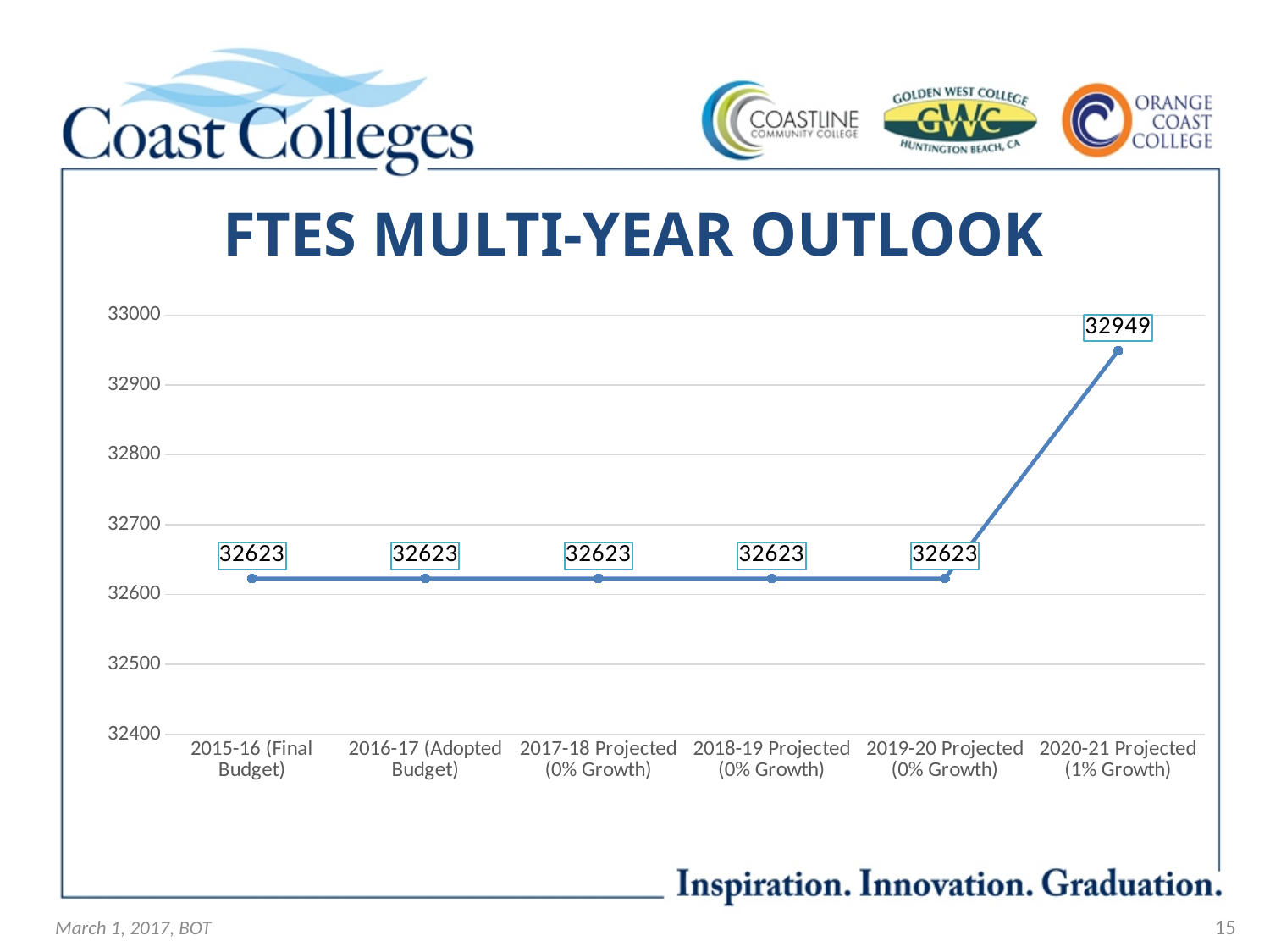
Which is larger, the FTES value for 2020-21 Projected (1% Growth) or 2016-17 (Adopted Budget)? 2020-21 Projected (1% Growth) What kind of chart is shown on the slide? line chart Which year has the highest FTES value? 2020-21 Projected (1% Growth) Do the FTES values rise, fall, or stay flat from 2015-16 (Final Budget) to 2019-20 Projected (0% Growth)? stay flat What is the FTES value for 2015-16 (Final Budget)? 32623 Is the FTES value for 2020-21 Projected (1% Growth) greater or less than 32900? greater What is the difference between the FTES value for 2020-21 Projected (1% Growth) and 2019-20 Projected (0% Growth)? 326 What is the title of the chart? FTES MULTI-YEAR OUTLOOK How many years are plotted on the chart? 6 What is the FTES value for 2018-19 Projected (0% Growth)? 32623 What is the FTES value for 2020-21 Projected (1% Growth)? 32949 Is the FTES value for 2017-18 Projected (0% Growth) greater or less than 32700? less